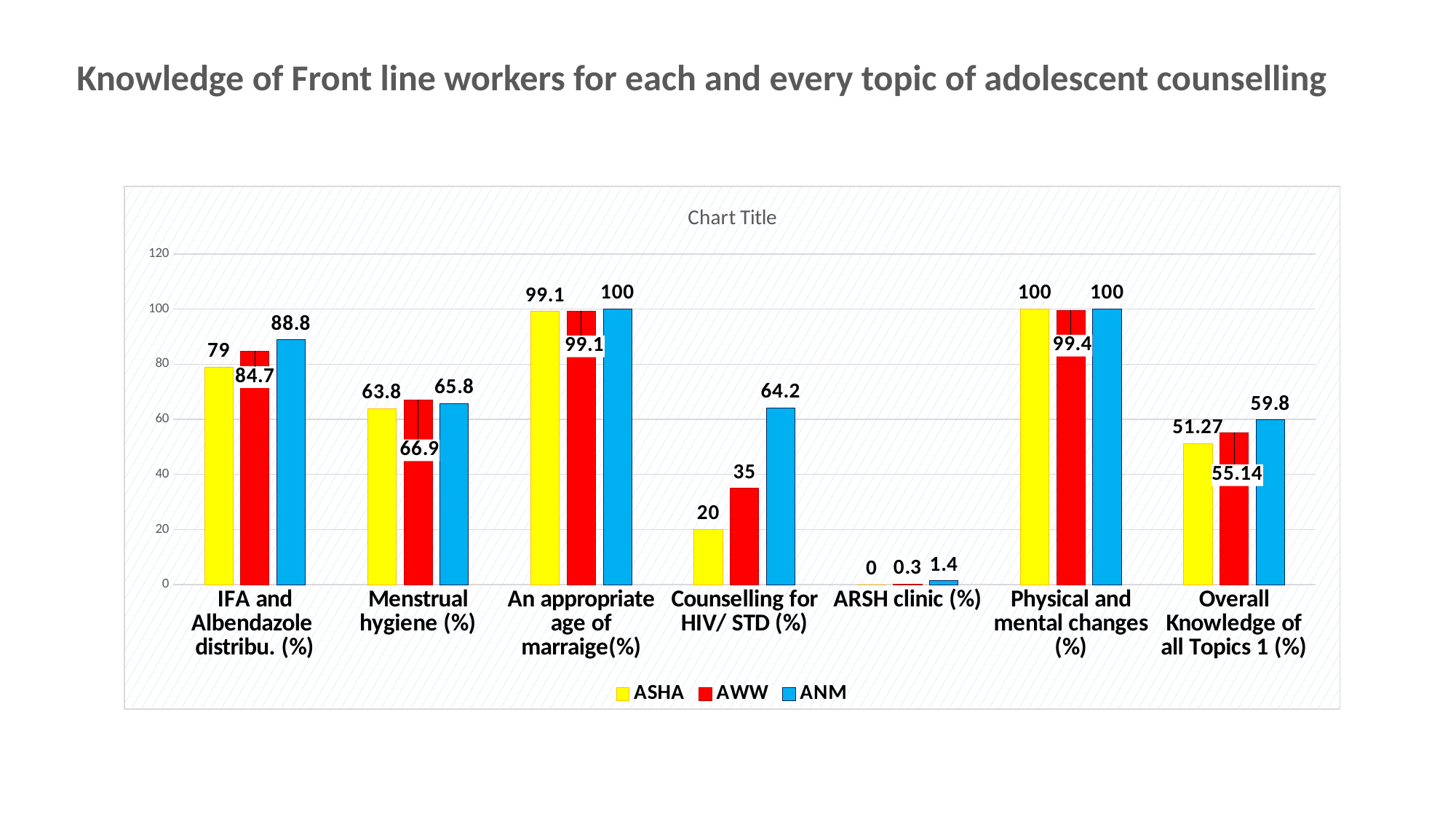
Which series is shown in yellow in the legend? ASHA What kind of chart is shown on the slide? Bar chart What is the ANM value for IFA and Albendazole distribu. (%)? 88.8 How many series does the legend list? 3 What is the ANM value for Overall Knowledge of all Topics 1 (%)? 59.8 Which is larger for Overall Knowledge of all Topics 1 (%): the ASHA value or the AWW value? AWW What is the ASHA value for Counselling for HIV/ STD (%)? 20 What is the AWW value for Menstrual hygiene (%)? 66.9 What is the difference between the ANM and ASHA values for Counselling for HIV/ STD (%)? 44.2 Which category has the lowest ASHA value? ARSH clinic (%) How many categories are shown on the x axis? 7